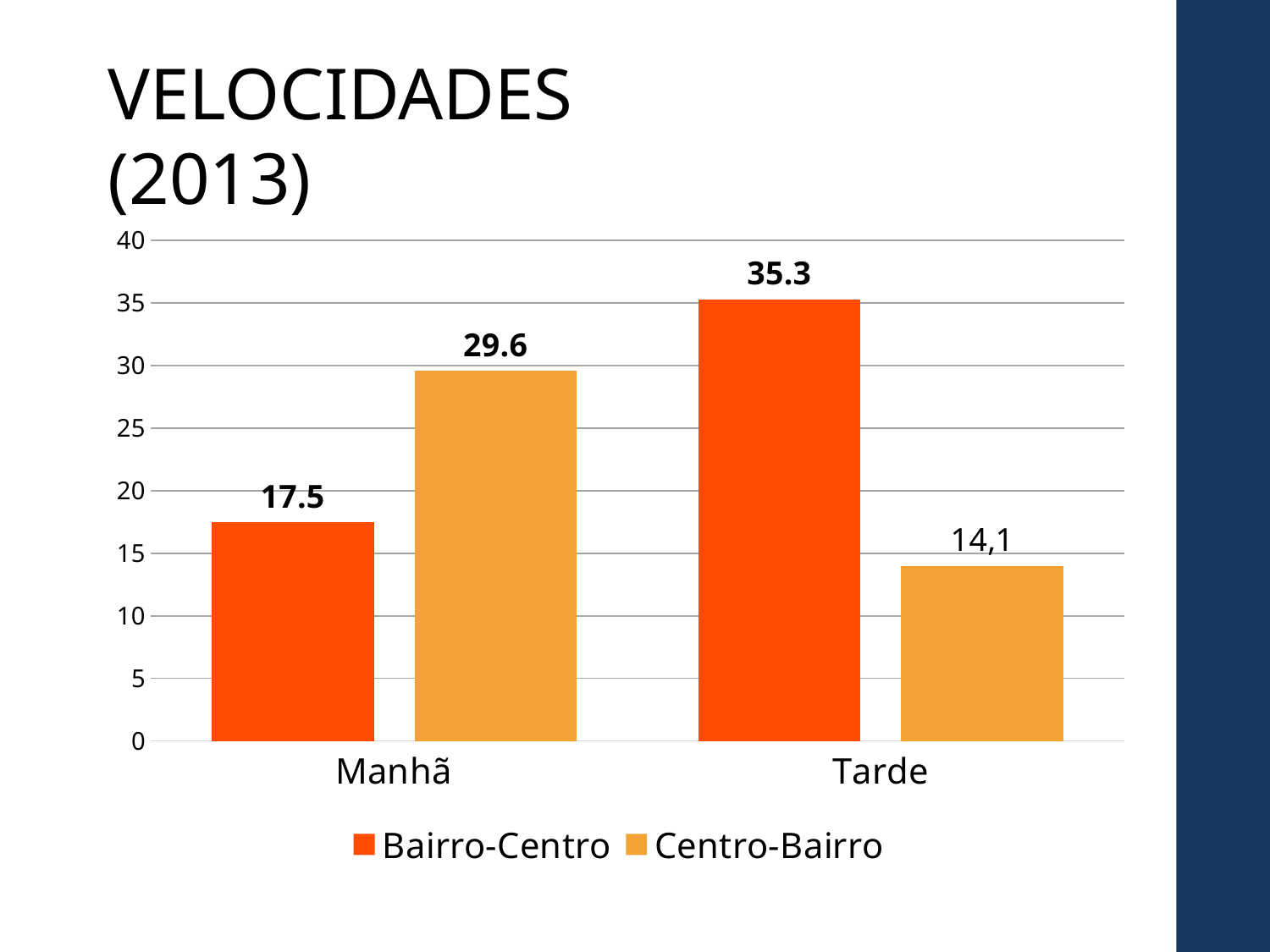
What is the Bairro-Centro value for Tarde? 35.3 Which bar has the highest value on the chart? Bairro-Centro, Tarde What is the Bairro-Centro value for Manhã? 17.5 What is the difference between the Centro-Bairro and Bairro-Centro values for Manhã? 12.1 Is the Bairro-Centro value for Tarde greater or less than 30? greater What kind of chart is shown on the slide? bar chart How many series does the legend list? 2 For Tarde, which series has the larger value, Bairro-Centro or Centro-Bairro? Bairro-Centro Which bar has the lowest value on the chart? Centro-Bairro, Tarde What is the Centro-Bairro value for Tarde? 14,1 How many categories are shown on the x axis? 2 What is the Centro-Bairro value for Manhã? 29.6